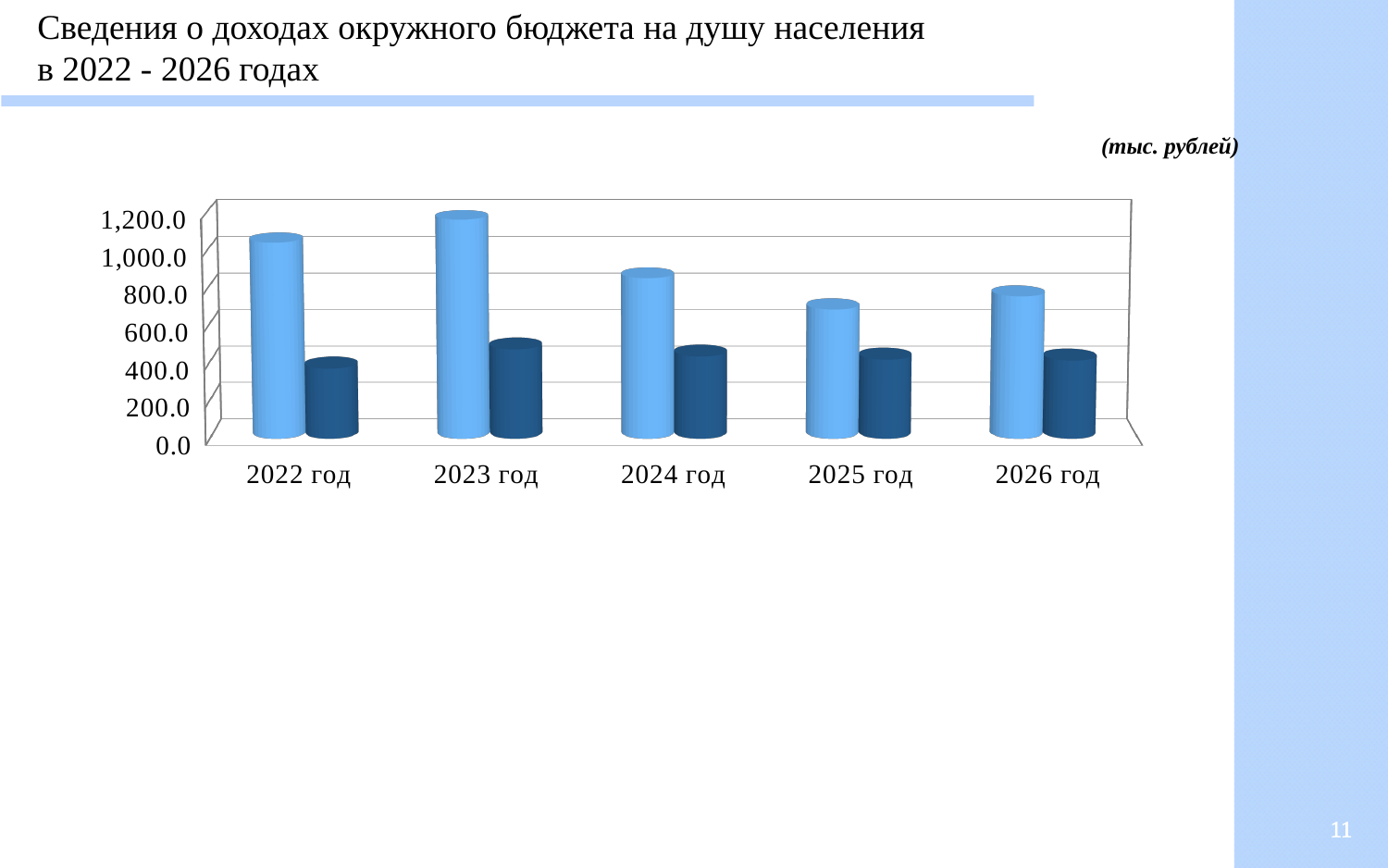
In which year is the light blue bar the shortest? 2025 год How many year categories are shown on the x axis of the chart? 5 What is the title of the slide containing the chart? Сведения о доходах окружного бюджета на душу населения в 2022 - 2026 годах Do the light blue bars rise or fall from 2023 год to 2025 год? fall Is the value of the light blue bar for 2023 год greater or less than 1,000.0? greater In which year is the light blue bar the tallest? 2023 год For 2022 год, which bar is taller, the light blue one or the dark blue one? the light blue one What unit of measurement is indicated above the chart? тыс. рублей Is the value of the dark blue bar for 2023 год greater or less than 200.0? greater Is the value of the light blue bar for 2025 год greater or less than 800.0? less What kind of chart is shown on the slide? bar chart